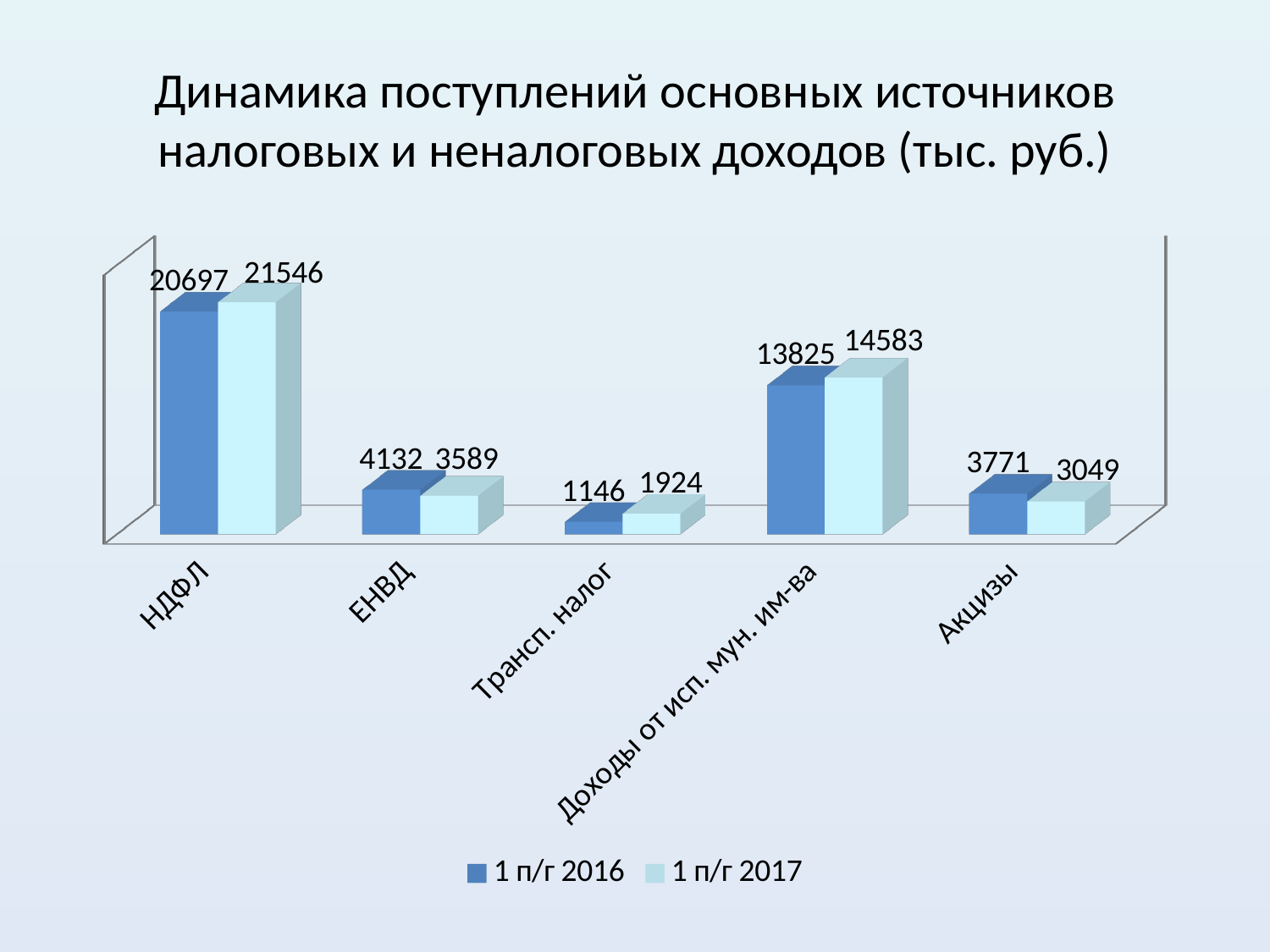
What unit is given in the chart title? тыс. руб. Which is larger for ЕНВД: the 1 п/г 2016 value or the 1 п/г 2017 value? 1 п/г 2016 What is the value for Трансп. налог in the 1 п/г 2016 series? 1146 Which category has the lowest value in the 1 п/г 2017 series? Трансп. налог What is the difference between the 1 п/г 2017 and 1 п/г 2016 values for Доходы от исп. мун. им-ва? 758 Which category has the highest value in the 1 п/г 2016 series? НДФЛ What is the difference between the 1 п/г 2016 and 1 п/г 2017 values for Акцизы? 722 What kind of chart is shown on the slide? Bar chart How many categories are shown on the x axis? 5 What is the value for НДФЛ in the 1 п/г 2017 series? 21546 What is the value for Акцизы in the 1 п/г 2017 series? 3049 How many series does the legend list? 2